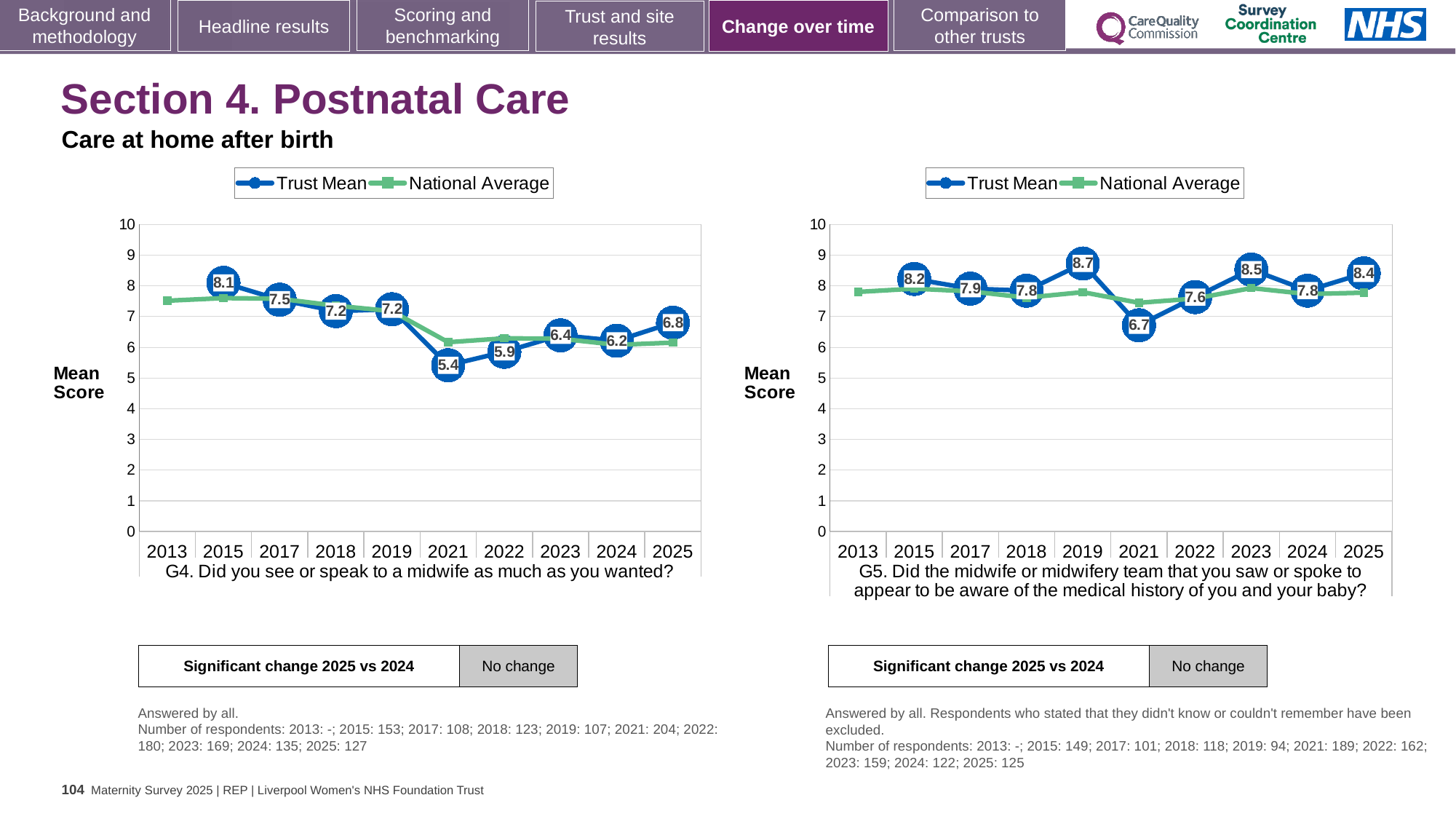
In the G4 chart (left), which year has the highest Trust Mean? 2015 In the G4 chart (left), is the National Average for 2013 greater or less than 7? greater In the G5 chart (right), what is the Trust Mean for 2019? 8.7 In the G4 chart (left), what is the difference between the Trust Mean for 2025 and 2024? 0.6 In the G5 chart (right), which is larger: the Trust Mean for 2023 or for 2025? 2023 In the G4 chart (left), does the Trust Mean rise or fall from 2015 to 2021? Fall What does the 'Significant change 2025 vs 2024' box below the G5 chart (right) say? No change In the G5 chart (right), which year has the lowest Trust Mean? 2021 What kind of chart is the G4 chart (left)? Line chart How many series does the legend of the G4 chart (left) list? 2 How many years are shown on the x axis of the G5 chart (right)? 10 In the G4 chart (left), what is the Trust Mean for 2021? 5.4